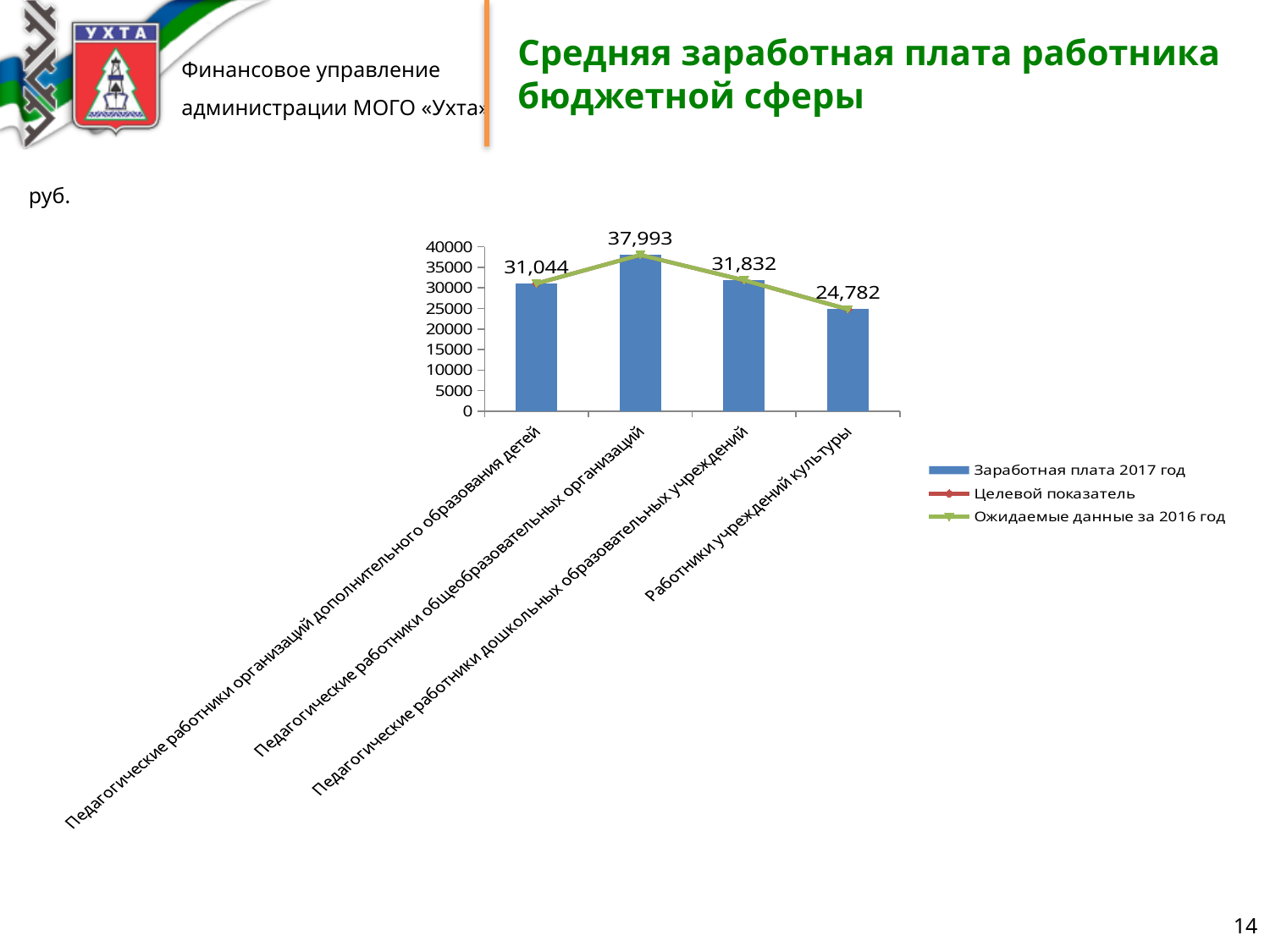
Is the value for 'Работники учреждений культуры' greater or less than 30000? less How many series does the chart legend list? 3 What is the data label shown for the category 'Работники учреждений культуры'? 24,782 Which category has the lowest labelled value? Работники учреждений культуры What unit is indicated for the values in the chart? руб. Which labelled value is larger: 'Педагогические работники дошкольных образовательных учреждений' or 'Педагогические работники организаций дополнительного образования детей'? Педагогические работники дошкольных образовательных учреждений What is the data label shown for the category 'Педагогические работники дошкольных образовательных учреждений'? 31,832 Which category has the highest labelled value? Педагогические работники общеобразовательных организаций What is the data label shown for the category 'Педагогические работники организаций дополнительного образования детей'? 31,044 What is the difference between the labelled values for 'Педагогические работники общеобразовательных организаций' and 'Работники учреждений культуры'? 13,211 How many categories are shown on the x axis of the chart? 4 What is the data label shown for the category 'Педагогические работники общеобразовательных организаций'? 37,993